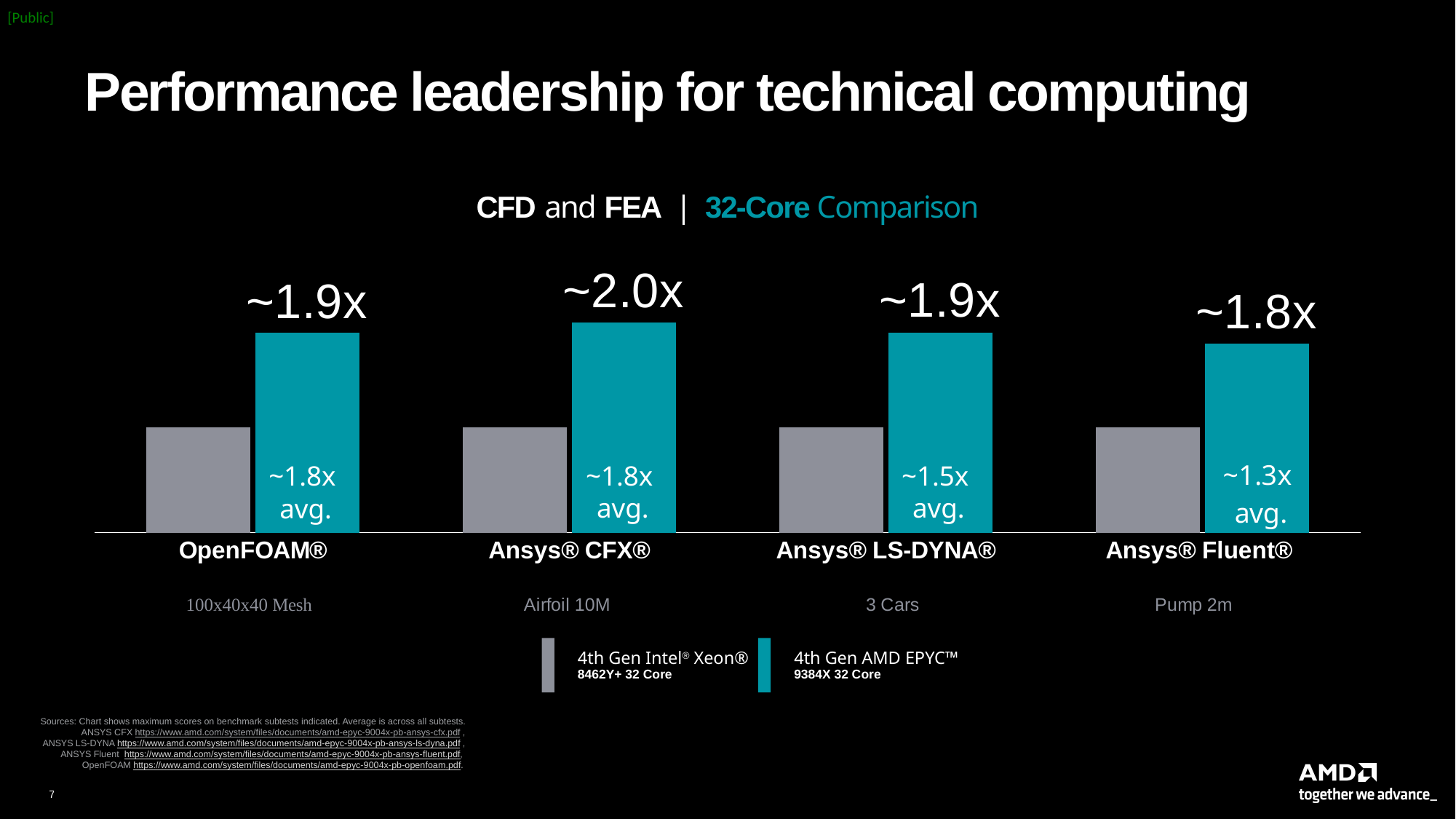
What performance multiplier is shown above the AMD EPYC bar for Ansys® CFX®? ~2.0x What benchmark case is listed under Ansys® LS-DYNA®? 3 Cars What performance multiplier is shown above the AMD EPYC bar for OpenFOAM®? ~1.9x Which benchmark shows the highest AMD EPYC performance multiplier? Ansys® CFX® What kind of chart is shown on the slide? Bar chart What average multiplier is printed inside the AMD EPYC bar for Ansys® LS-DYNA®? ~1.5x avg. Which processor does the teal bar represent according to the legend? 4th Gen AMD EPYC™ 9384X 32 Core What average multiplier is printed inside the AMD EPYC bar for Ansys® Fluent®? ~1.3x avg. How many series does the legend list? 2 How many benchmark categories are shown on the chart? 4 Which has the taller AMD EPYC bar, OpenFOAM® or Ansys® Fluent®? OpenFOAM® Which benchmark shows the lowest AMD EPYC performance multiplier? Ansys® Fluent®